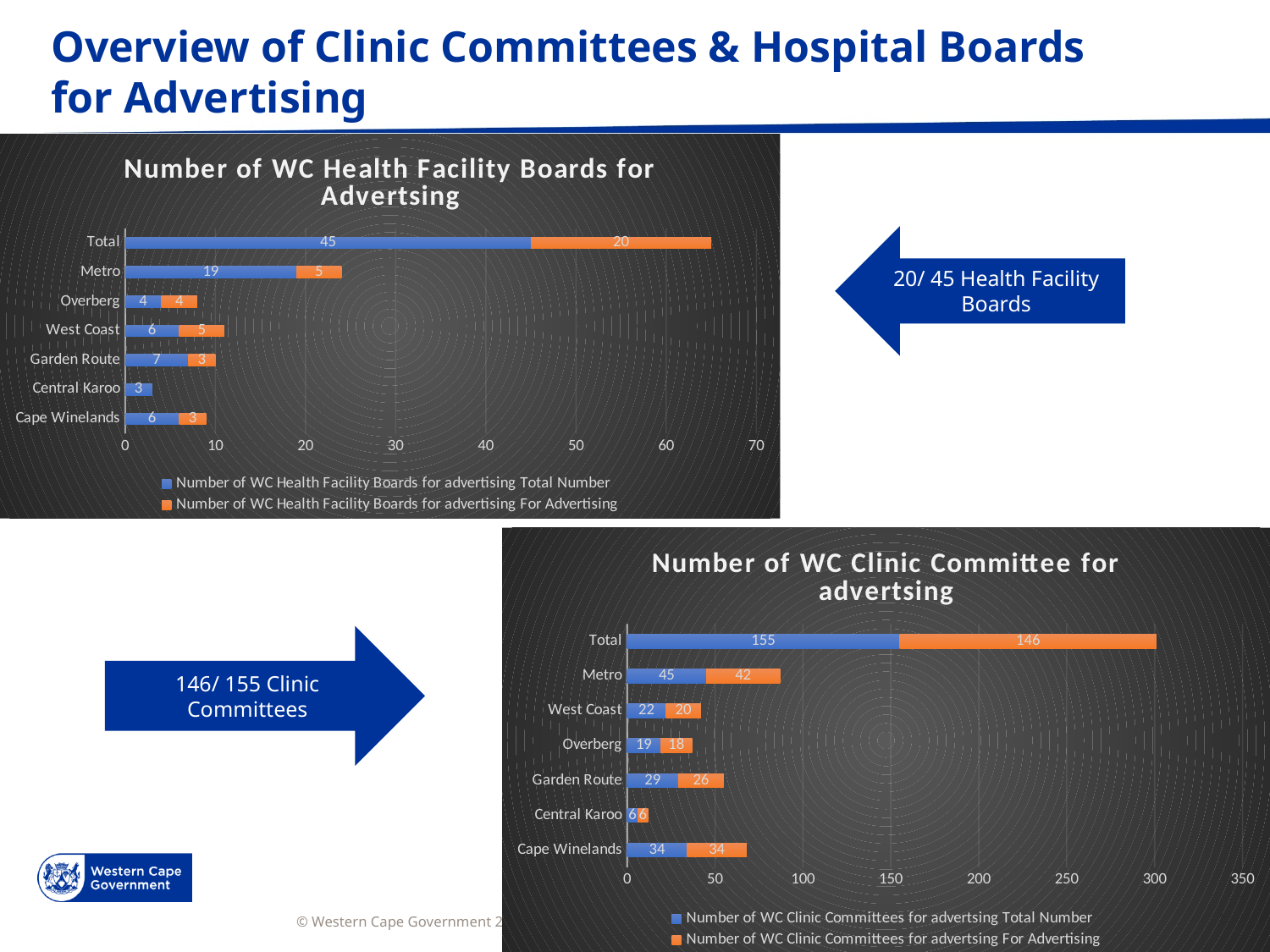
In the 'Number of WC Health Facility Boards for Advertsing' chart, how many series does the legend list? 2 In the 'Number of WC Health Facility Boards for Advertsing' chart, what is the total length of the stacked bar for Garden Route? 10 In the 'Number of WC Clinic Committee for advertising' chart, what is the Total Number value for Cape Winelands? 34 In the 'Number of WC Health Facility Boards for Advertsing' chart, what is the For Advertising value for Overberg? 4 In the 'Number of WC Clinic Committee for advertising' chart, what is the difference between the Total Number and For Advertising values for Metro? 3 In the 'Number of WC Clinic Committee for advertising' chart, what is the For Advertising value for Garden Route? 26 What type of chart is the 'Number of WC Clinic Committee for advertising' chart? Stacked bar chart In the 'Number of WC Clinic Committee for advertising' chart, how many categories are shown on the vertical axis? 7 In the 'Number of WC Health Facility Boards for Advertsing' chart, excluding Total, which region has the highest Total Number value? Metro In the 'Number of WC Health Facility Boards for Advertsing' chart, what is the Total Number value for Metro? 19 In the 'Number of WC Clinic Committee for advertising' chart, is the Total Number value for West Coast larger or smaller than that for Overberg? larger In the 'Number of WC Clinic Committee for advertising' chart, excluding Total, which region has the lowest Total Number value? Central Karoo